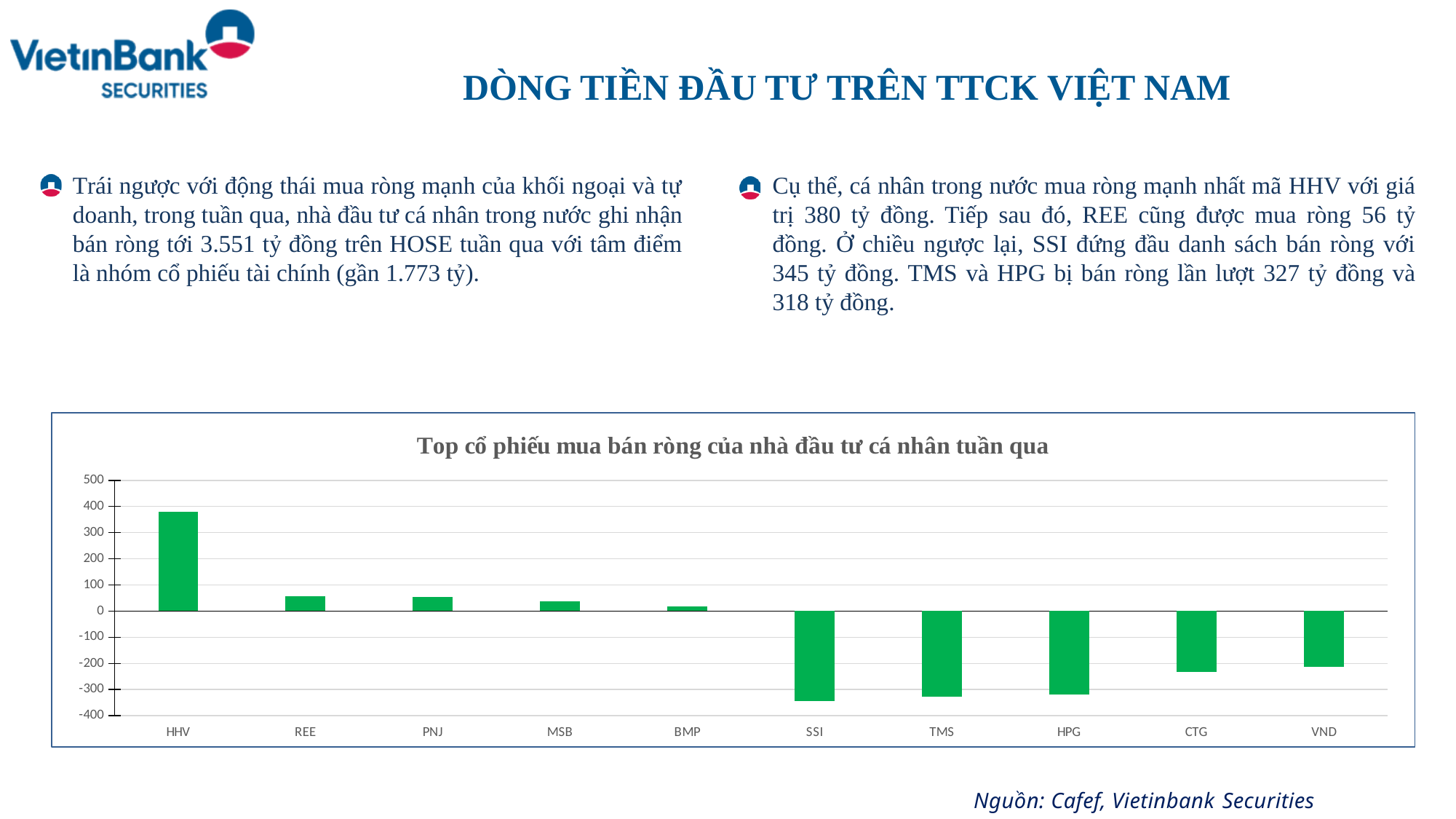
Is the value for CTG greater or less than -300? greater Is the value for HHV greater or less than 300? greater What kind of chart is shown on the slide? bar chart Which stock has the highest value in the chart? HHV How many stock categories are shown on the x axis of the chart? 10 What is the title of the chart? Top cổ phiếu mua bán ròng của nhà đầu tư cá nhân tuần qua Is the value for SSI greater or less than -300? less Which is larger, the value for BMP or the value for SSI? BMP Which is larger, the value for HHV or the value for REE? HHV How many bars in the chart extend below zero? 5